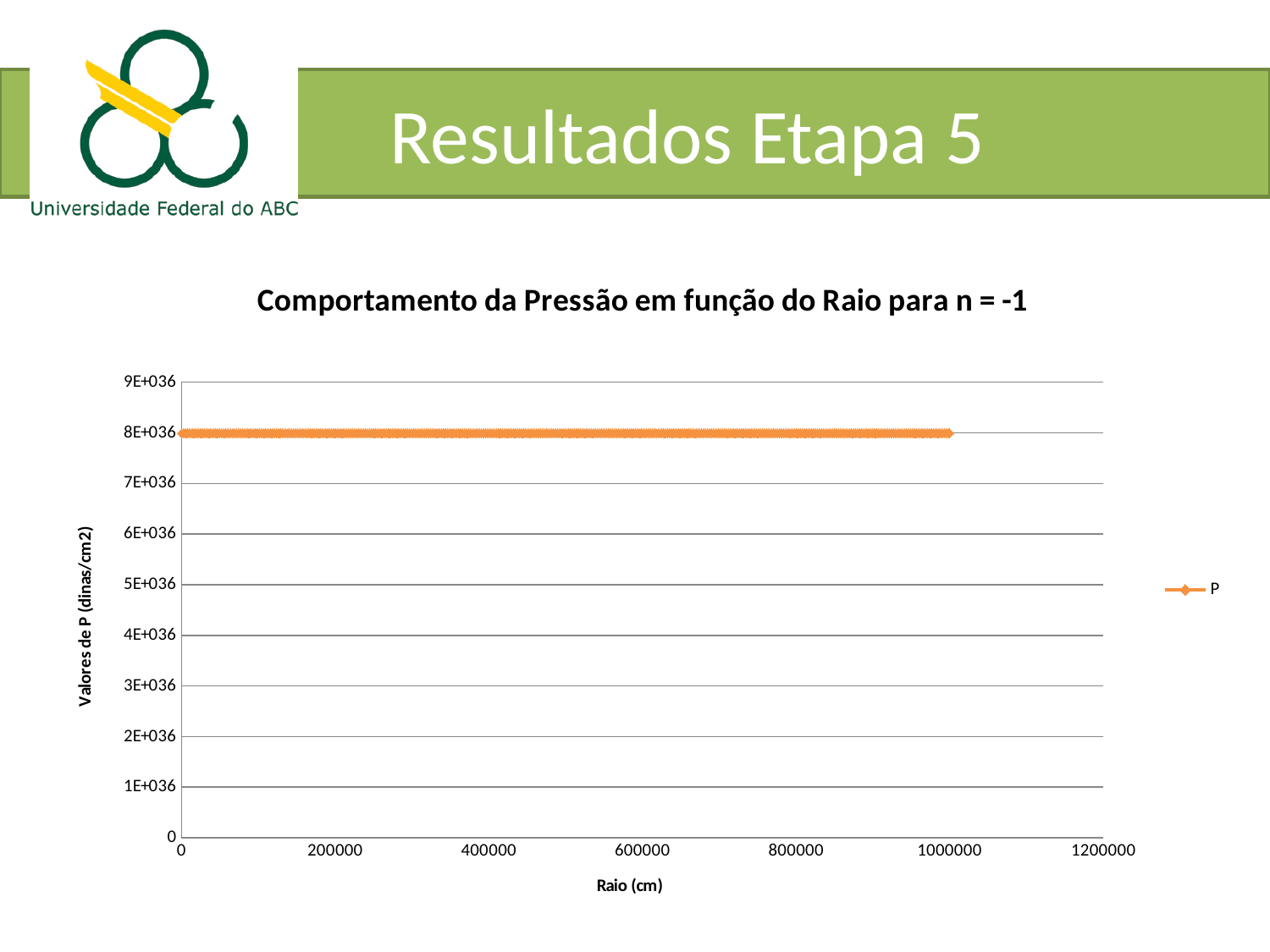
Is the value of P at a radius of 200000 cm greater or less than 7E+036? greater How many series does the legend list? 1 Does the value of P rise, fall, or stay constant as the radius increases along the x axis? Stays constant Is the value of P at a radius of 600000 cm larger or smaller than the value at a radius of 200000 cm? They are equal Is the value of P at a radius of 400000 cm greater or less than 5E+036? greater Is the value of P at a radius of 800000 cm greater or less than 9E+036? less At which y-axis tick value does the plotted line of P lie? 8E+036 Up to which x-axis tick value does the plotted data for P extend? 1000000 What type of chart is shown on the slide? Line chart What is the name of the series shown in the legend? P What is the title of the chart? Comportamento da Pressão em função do Raio para n = -1